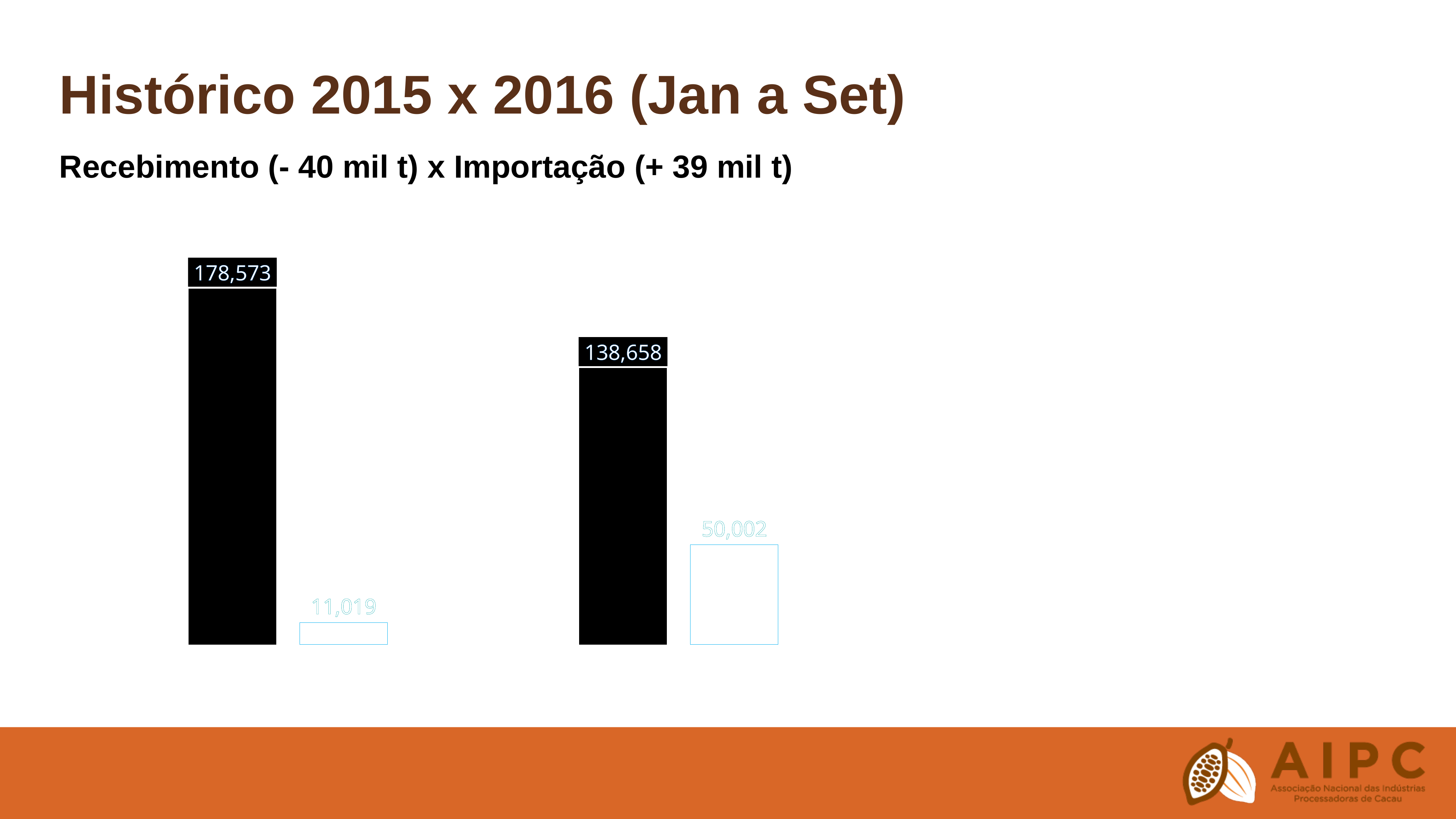
What is the value labelled on the small light-blue outlined bar on the left? 11,019 How many bars are plotted in the chart? 4 What is the difference between the two black bars (178,573 and 138,658)? 39,915 What is the value labelled on the leftmost (tallest) black bar? 178,573 What is the value labelled on the second black bar, on the right side of the chart? 138,658 What is the lowest value shown in the chart? 11,019 What is the difference between the two light-blue bars (50,002 and 11,019)? 38,983 Which light-blue bar is larger, the one on the left or the one on the right? the one on the right (50,002) What is the title of the slide? Histórico 2015 x 2016 (Jan a Set) What is the highest value shown in the chart? 178,573 What is the value labelled on the light-blue outlined bar on the right? 50,002 What kind of chart is shown on the slide? bar chart